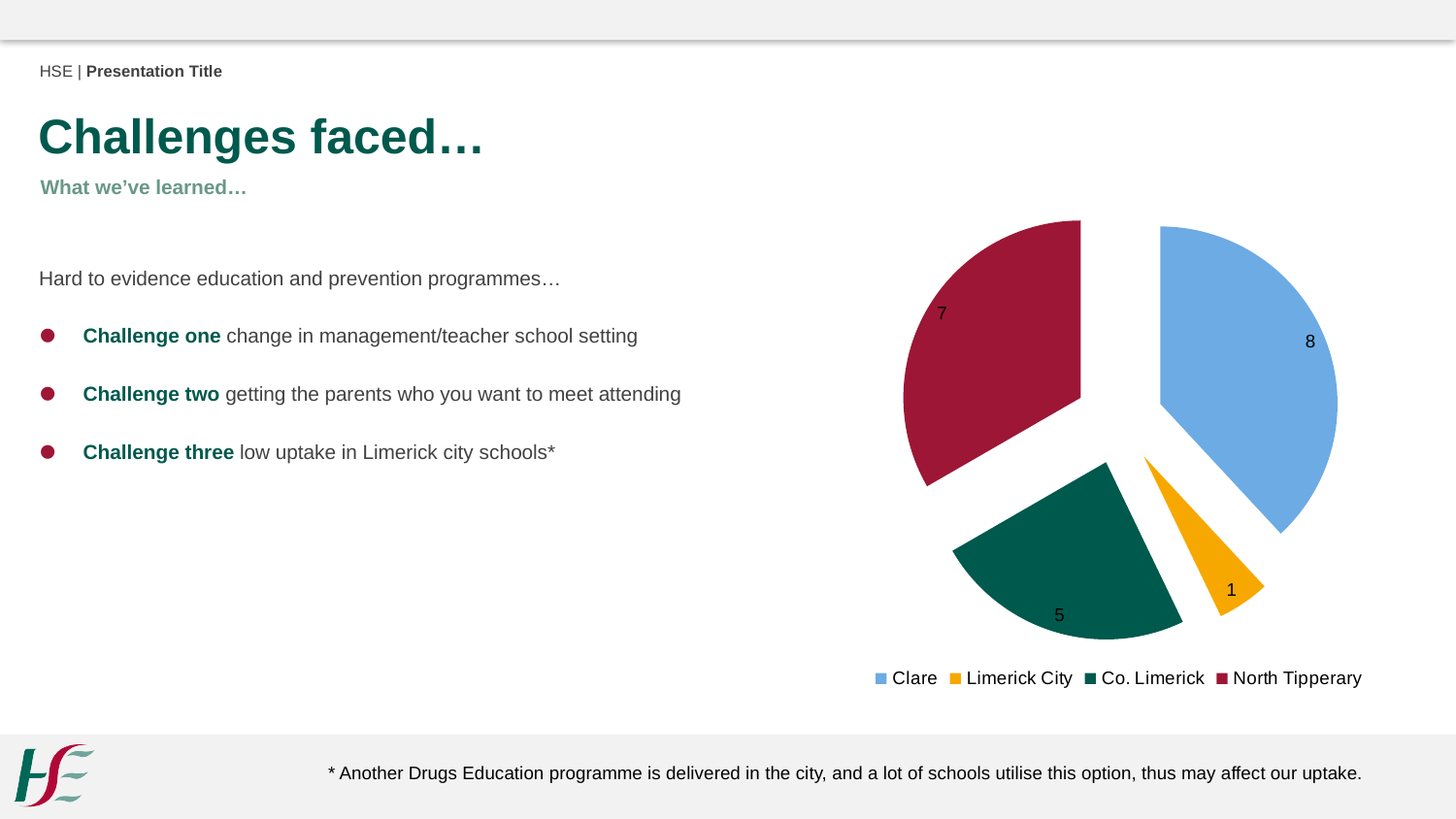
Which category has the smallest slice in the pie chart? Limerick City What is the value for Co. Limerick in the pie chart? 5 How many slices does the pie chart have? 4 Which is larger, the value for North Tipperary or the value for Co. Limerick? North Tipperary What is the difference between the values for Clare and Co. Limerick? 3 Which category has the largest slice in the pie chart? Clare What is the value for Limerick City in the pie chart? 1 What kind of chart is shown on the slide? Pie chart What is the total of all the values shown in the pie chart? 21 What is the value for Clare in the pie chart? 8 What share of the pie chart's total does Clare account for? 8 out of 21 What is the value for North Tipperary in the pie chart? 7